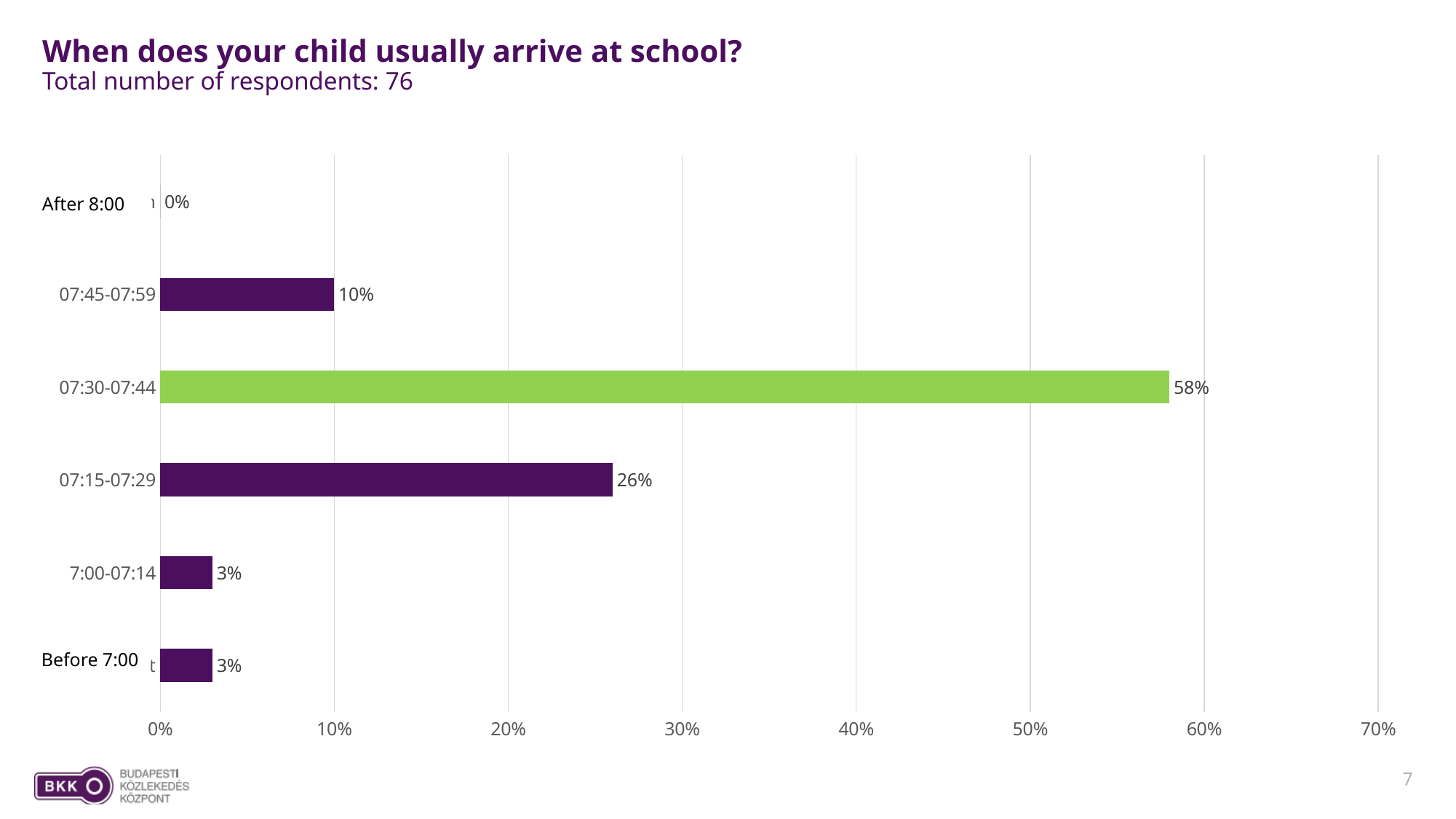
What percentage is shown for the 07:45-07:59 category? 10% What is the value shown for the 07:15-07:29 category? 26% What value is shown for the After 8:00 category? 0% How many arrival time categories are shown on the chart? 6 What is the difference in percentage points between the 07:30-07:44 and 07:15-07:29 categories? 32 Which arrival time category has the highest percentage? 07:30-07:44 Which arrival time category has the lowest percentage? After 8:00 What is the total number of respondents stated on the slide? 76 What kind of chart is shown on the slide? Bar chart Which bar is coloured green rather than purple? 07:30-07:44 What percentage of respondents said their child usually arrives at school between 07:30 and 07:44? 58% Which category has a larger value, 07:45-07:59 or 07:15-07:29? 07:15-07:29